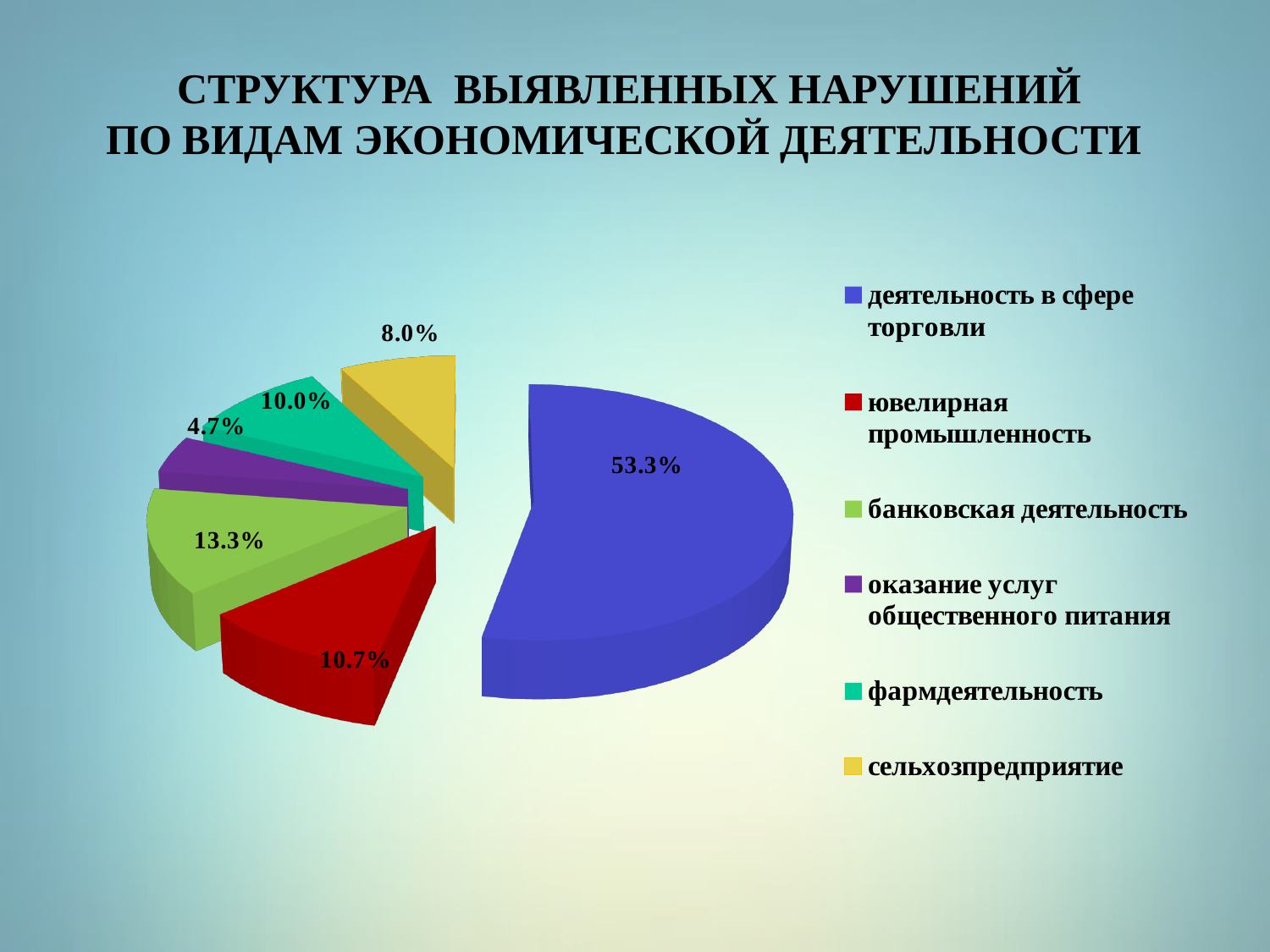
What is the difference between the shares of банковская деятельность and фармдеятельность? 3.3% What kind of chart is shown on the slide? pie chart What share of the pie does сельхозпредприятие have? 8.0% What share of the pie does деятельность в сфере торговли have? 53.3% Which category has the largest slice of the pie? деятельность в сфере торговли Which is larger, the share of ювелирная промышленность or the share of сельхозпредприятие? ювелирная промышленность What colour is the slice for фармдеятельность? teal (green-blue) How many categories does the legend list? 6 What share of the pie does банковская деятельность have? 13.3% What share of the pie does оказание услуг общественного питания have? 4.7% Which category has the smallest slice of the pie? оказание услуг общественного питания What share of the pie does ювелирная промышленность have? 10.7%